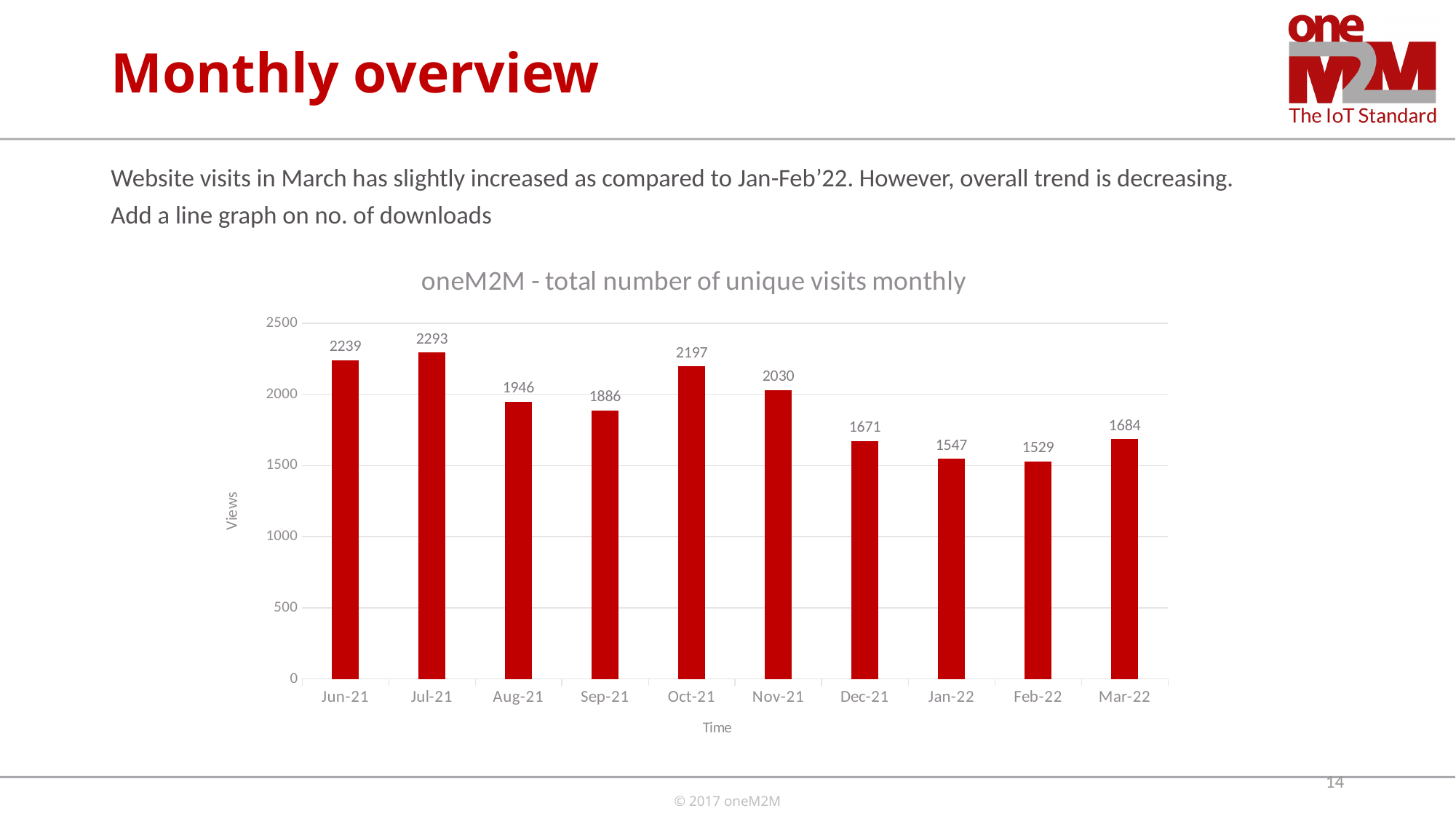
What is the number of unique visits for Oct-21? 2197 Which month has the highest number of unique visits? Jul-21 What is the number of unique visits for Feb-22? 1529 How many months are shown on the x axis? 10 Which month has the lowest number of unique visits? Feb-22 What is the difference in unique visits between Jul-21 and Jun-21? 54 What is the difference in unique visits between Mar-22 and Feb-22? 155 Is the value for Sep-21 greater or less than 2000? less What kind of chart is shown on the slide? bar chart What is the title of the chart? oneM2M - total number of unique visits monthly Which month has more unique visits, Nov-21 or Dec-21? Nov-21 Do the values generally rise or fall from Jun-21 to Feb-22? fall